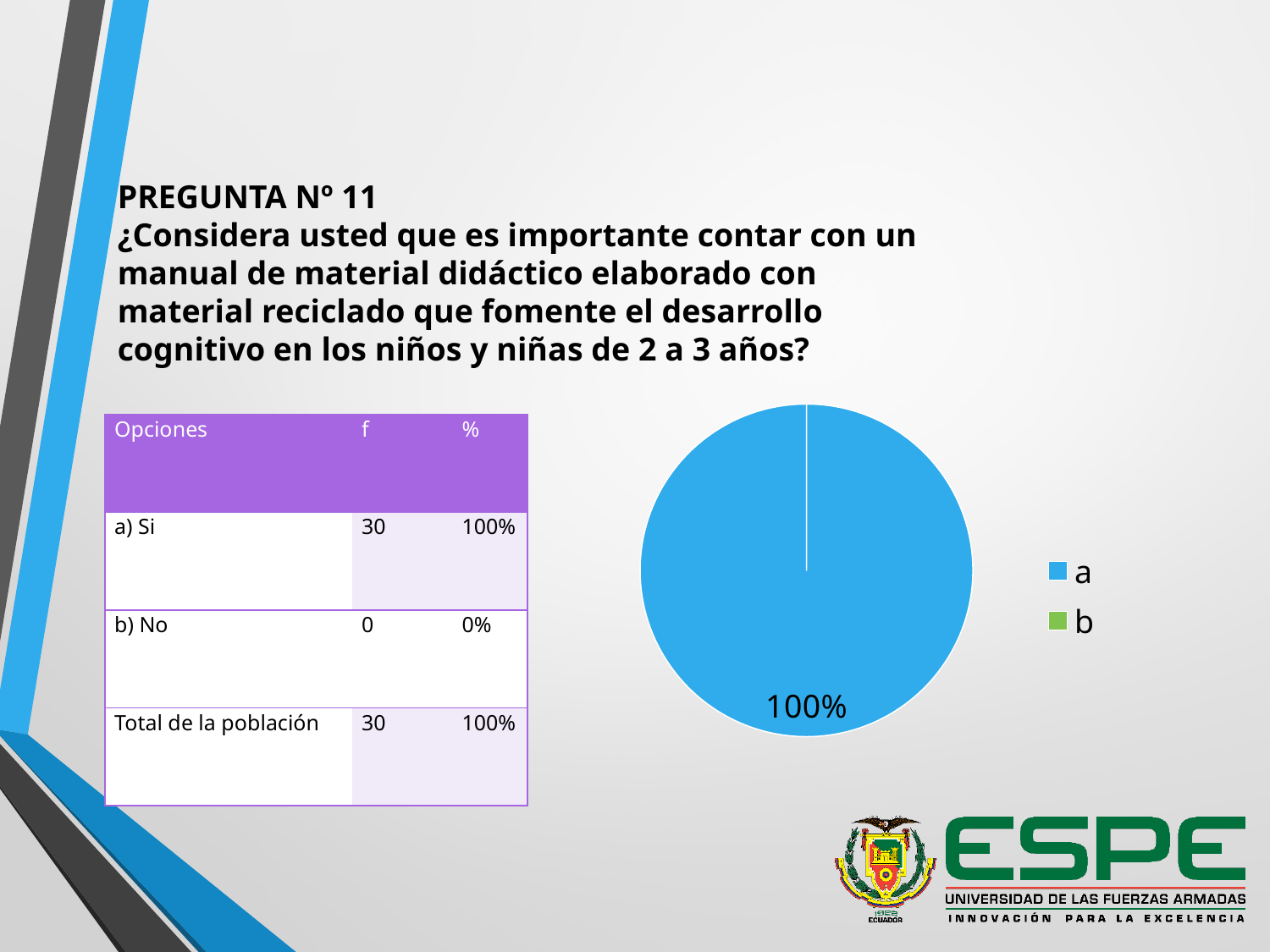
Which legend entry has the smallest slice in the pie chart? b Which legend entry has the largest slice in the pie chart? a What colour does the legend use for entry b? green According to the table next to the chart, what is the frequency (f) for option a) Si? 30 According to the table next to the chart, what percentage corresponds to option b) No? 0% How many entries does the legend of the pie chart list? 2 What share of the pie does slice a represent? 100% What kind of chart is shown on the slide? pie chart What colour is the slice for legend entry a in the pie chart? blue What is the difference in percentage between option a) Si and option b) No shown in the table? 100% What percentage label is printed on the pie chart? 100% Which is larger in the pie chart, slice a or slice b? a